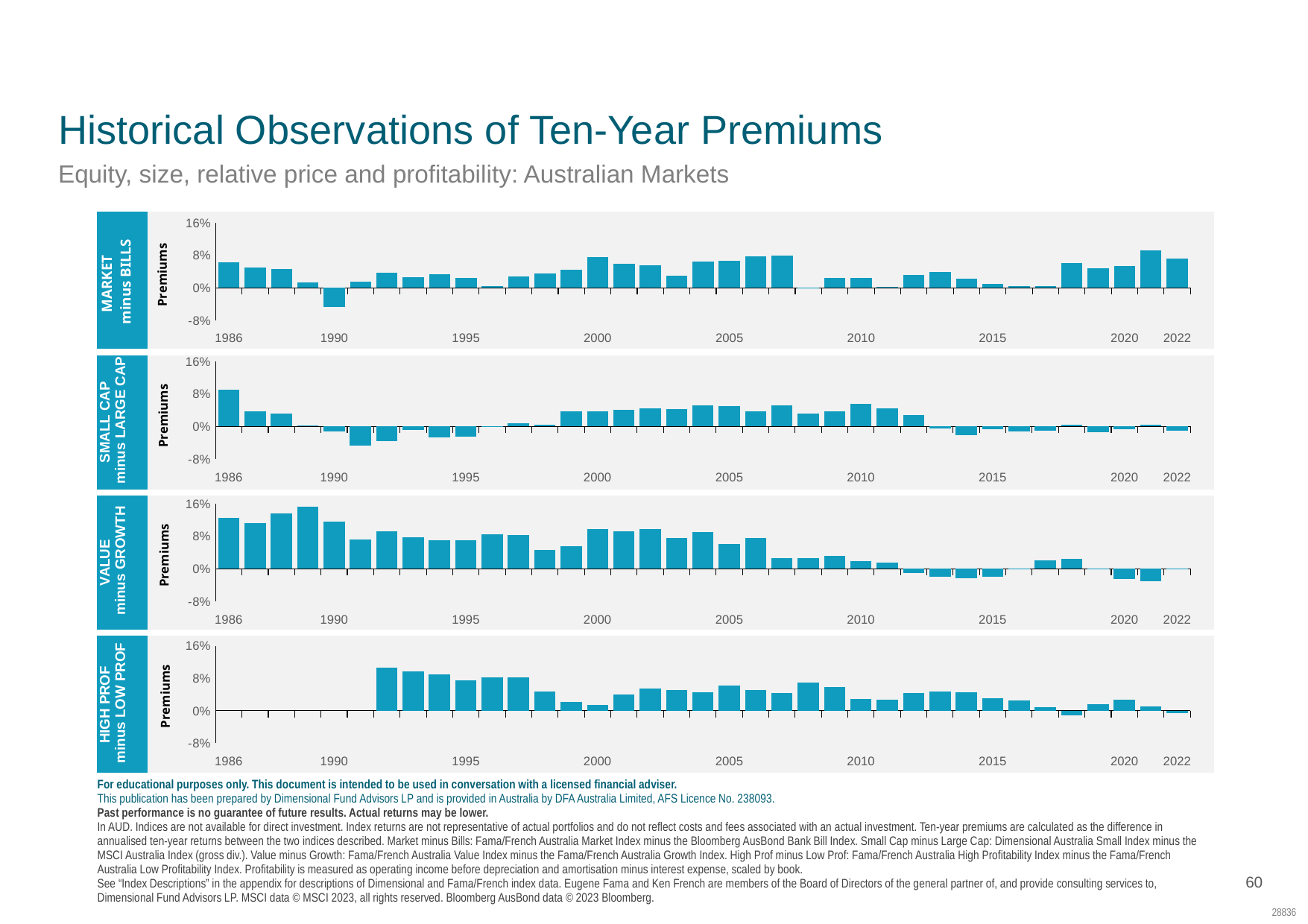
In the VALUE minus GROWTH chart, which year has the highest premium? 1989 In the VALUE minus GROWTH chart, is the value for 1989 greater or less than 8%? greater In the MARKET minus BILLS chart, is the value for 1990 greater or less than 0%? less What type of chart is used on this slide to show the ten-year premiums? Bar chart In the MARKET minus BILLS chart, which year has the lowest premium? 1990 What is the label on the vertical axis of each chart? Premiums In the HIGH PROF minus LOW PROF chart, do the premiums generally rise or fall from 1992 to 2022? fall In the SMALL CAP minus LARGE CAP chart, is the value for 1986 greater or less than 8%? greater How many separate charts are shown on the slide? 4 In the HIGH PROF minus LOW PROF chart, which year has the highest premium? 1992 In the SMALL CAP minus LARGE CAP chart, which year has the highest premium? 1986